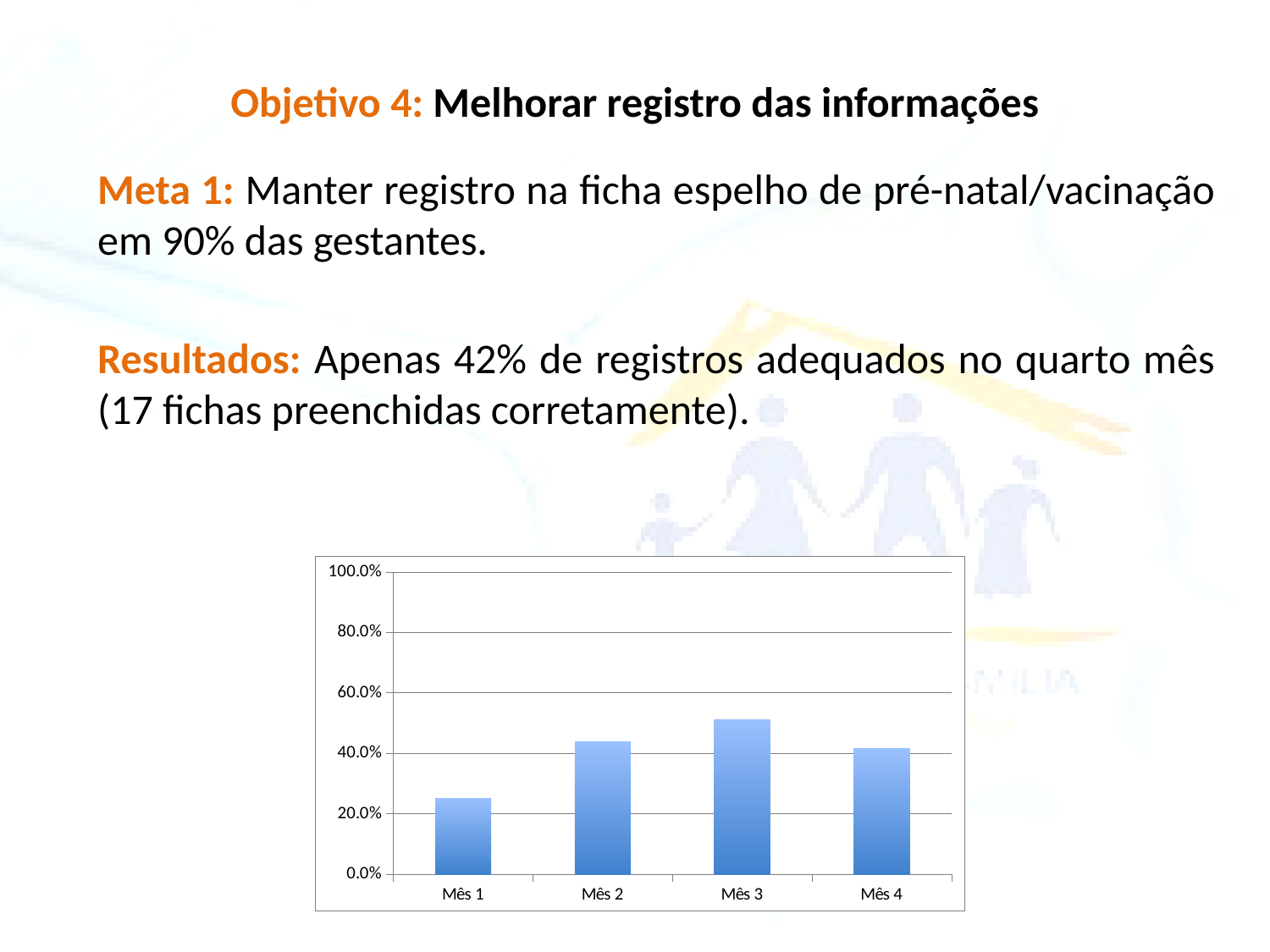
Is the value for Mês 3 greater or less than 60.0%? less What kind of chart is shown on the slide? bar chart Do the values rise or fall from Mês 1 to Mês 3? rise Which is larger, the value for Mês 1 or the value for Mês 2? Mês 2 Is the value for Mês 3 greater or less than 40.0%? greater Is the value for Mês 1 greater or less than 20.0%? greater How many categories (months) are shown on the x axis of the chart? 4 Which month has the highest bar in the chart? Mês 3 Which is larger, the value for Mês 3 or the value for Mês 4? Mês 3 Which month has the lowest bar in the chart? Mês 1